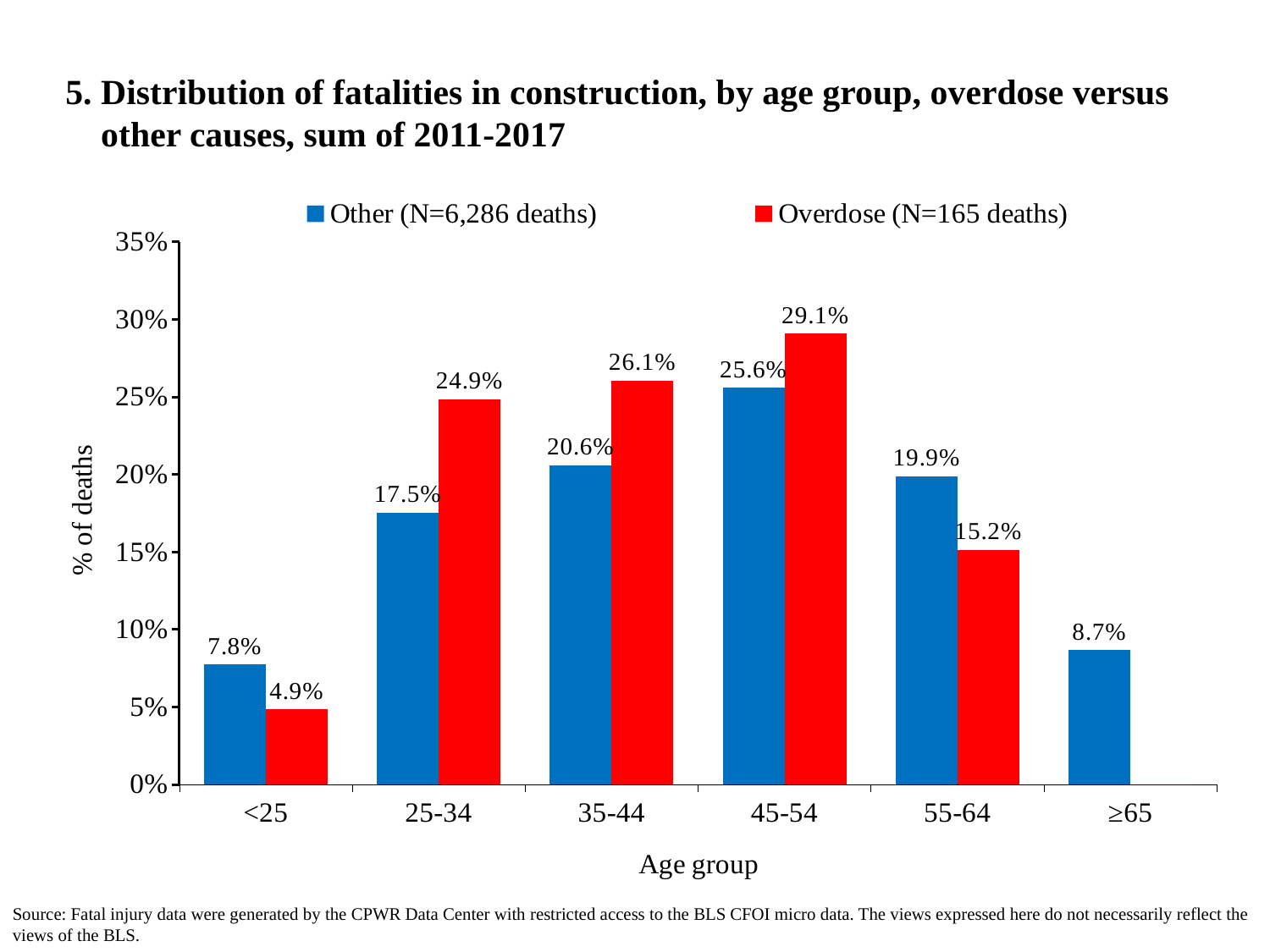
What is the difference between the Overdose and Other values for the 25-34 age group? 7.4% Which age group has the lowest value in the Other series? <25 What is the label of the y axis? % of deaths What percentage of deaths does the Other series show for the <25 age group? 7.8% What is the value for the Other series in the 55-64 age group? 19.9% How many series does the legend list? 2 What percentage of deaths does the Overdose series show for the 45-54 age group? 29.1% For the 55-64 age group, which series has the larger value, Other or Overdose? Other What kind of chart is shown on the slide? Bar chart Which age group has no Overdose bar shown? ≥65 Which age group has the highest value in the Overdose series? 45-54 How many age groups are shown on the x axis? 6